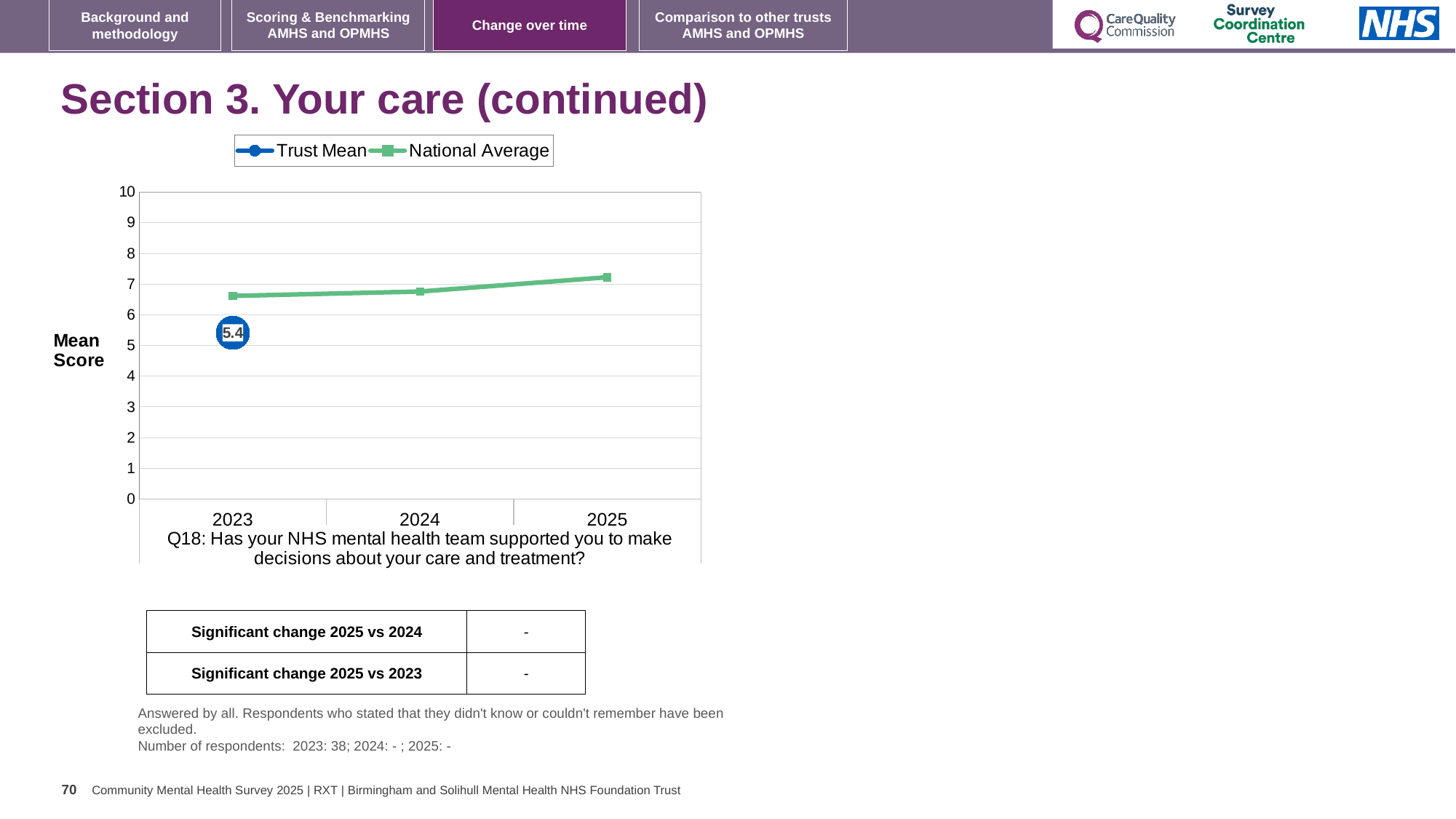
What is the label on the y axis? Mean Score How many years are shown on the x axis? 3 Is the National Average value for 2025 greater or less than 8? less Is the National Average value for 2024 greater or less than 5? greater Does the National Average rise or fall from 2023 to 2025? rise Which series is drawn in green? National Average What is the Trust Mean value for 2023? 5.4 For how many years is a Trust Mean point plotted? 1 In 2023, which is larger: the Trust Mean or the National Average? National Average How many series does the legend list? 2 Is the National Average value for 2023 greater or less than 6? greater What kind of chart is shown on the slide? line chart